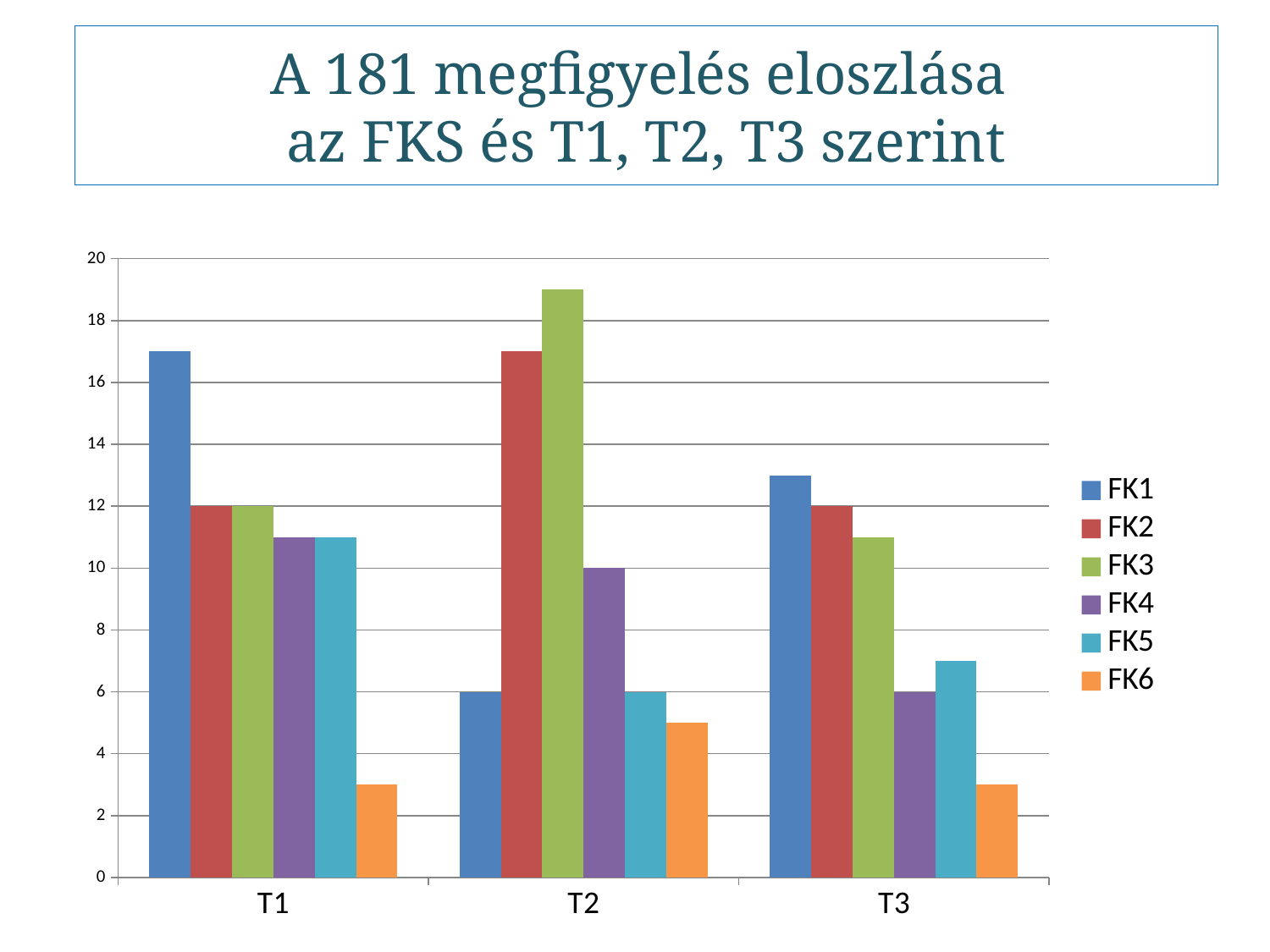
Which series has the highest value in the T2 group? FK3 What kind of chart is shown on the slide? bar chart Is the value for FK1 in T1 greater or less than 16? greater What is the value for FK4 in T2? 10 Which series has the highest value in the T3 group? FK1 How many series does the legend list? 6 What is the title of the chart on the slide? A 181 megfigyelés eloszlása az FKS és T1, T2, T3 szerint Which is larger in the T2 group, FK1 or FK2? FK2 Is the value for FK6 in T3 greater or less than 4? less How many categories are shown on the x axis? 3 Which series has the lowest value in the T1 group? FK6 Is the value for FK3 in T2 greater or less than 18? greater